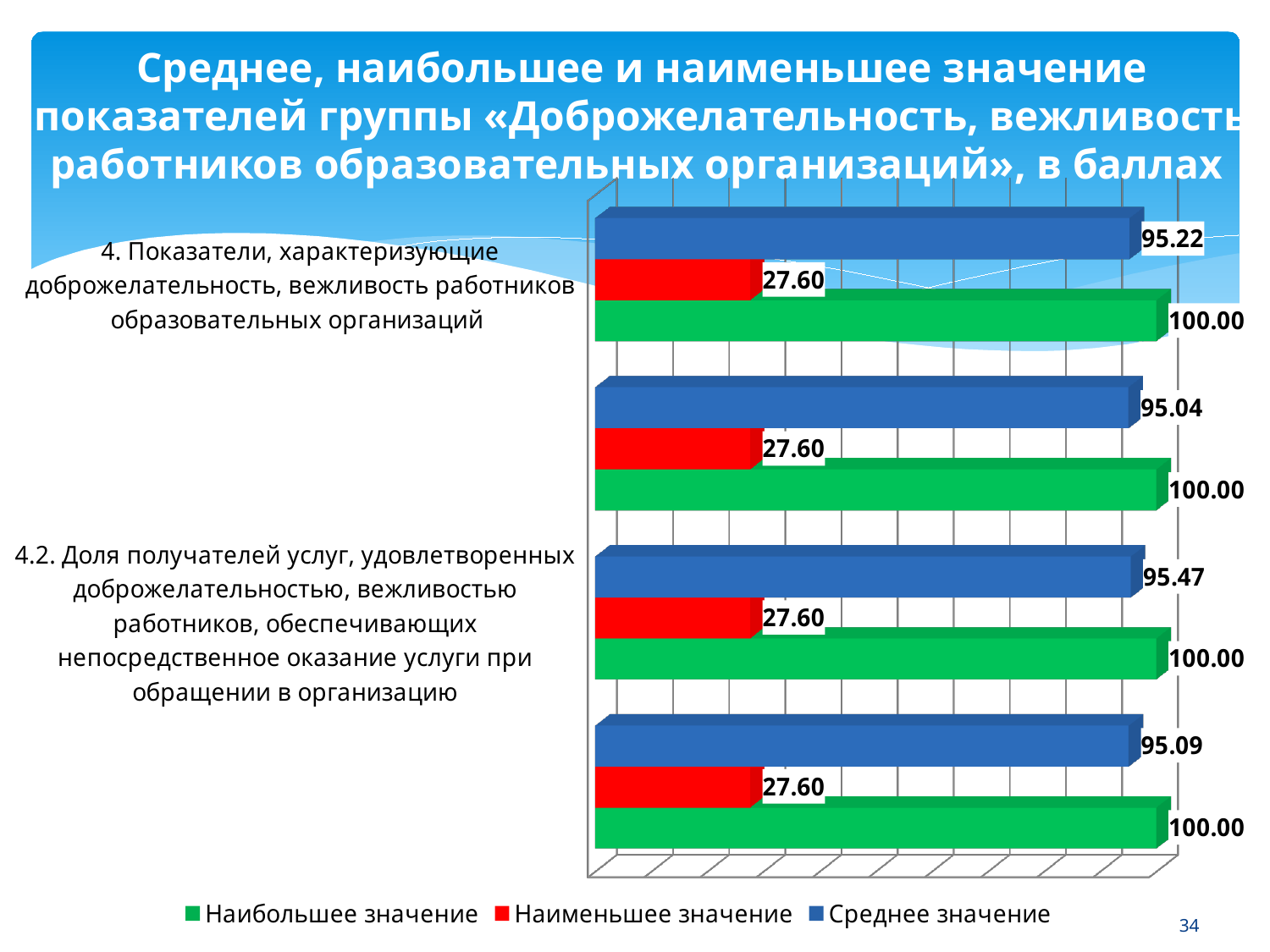
What is the value of «Среднее значение» for the category «4. Показатели, характеризующие доброжелательность, вежливость работников образовательных организаций»? 95.22 Which series has the lowest value for the category «4. Показатели, характеризующие доброжелательность, вежливость работников образовательных организаций»? Наименьшее значение What is the value of «Наибольшее значение» for the category «4.2. Доля получателей услуг, удовлетворенных доброжелательностью, вежливостью работников...»? 100.00 Which series has the highest value for the category «4.2. Доля получателей услуг, удовлетворенных доброжелательностью...»? Наибольшее значение What kind of chart is shown on the slide? Bar chart Which is larger: «Среднее значение» for category «4.» or «Среднее значение» for category «4.2.»? 4.2. What colour represents «Среднее значение» in the legend? Blue What is the difference between «Наибольшее значение» and «Наименьшее значение» for the category «4. Показатели, характеризующие доброжелательность, вежливость работников образовательных организаций»? 72.40 What is the value of «Наименьшее значение» for the category «4. Показатели, характеризующие доброжелательность, вежливость работников образовательных организаций»? 27.60 What is the difference between «Наибольшее значение» and «Среднее значение» for the category «4.2. Доля получателей услуг, удовлетворенных доброжелательностью...»? 4.53 How many series does the legend list? 3 What is the value of «Среднее значение» for the category «4.2. Доля получателей услуг, удовлетворенных доброжелательностью, вежливостью работников, обеспечивающих непосредственное оказание услуги при обращении в организацию»? 95.47